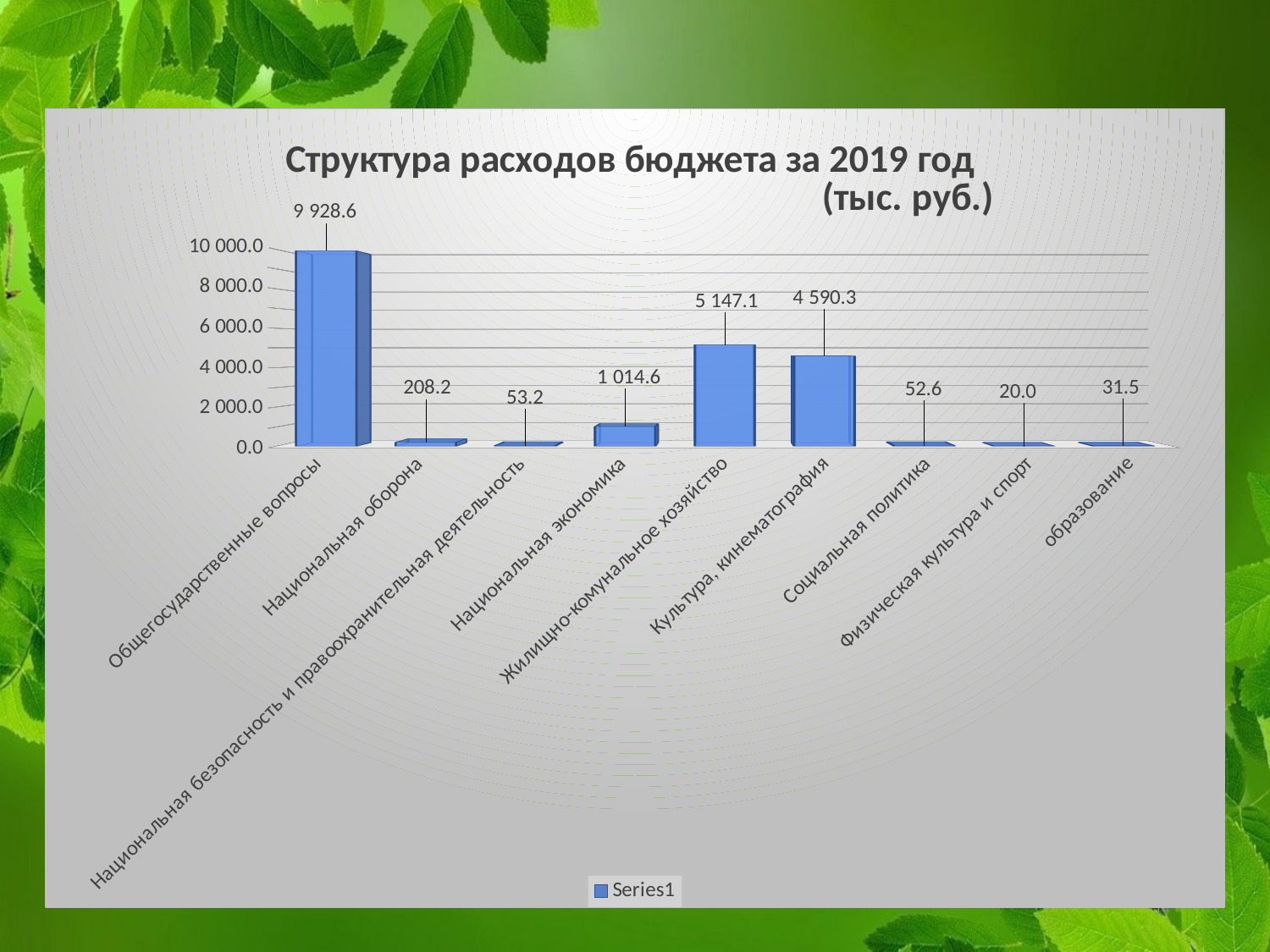
How many categories are shown on the chart? 9 What is the value for Национальная экономика? 1 014.6 What is the value for Общегосударственные вопросы? 9 928.6 What kind of chart is shown? Bar chart Which category has the highest value? Общегосударственные вопросы Which is larger, Национальная оборона or Социальная политика? Национальная оборона What is the title of the chart? Структура расходов бюджета за 2019 год (тыс. руб.) How many series does the legend list? 1 Which category has the lowest value? Физическая культура и спорт What is the value for Жилищно-комунальное хозяйство? 5 147.1 What is the value for Физическая культура и спорт? 20.0 What is the difference between Жилищно-комунальное хозяйство and Культура, кинематография? 556.8